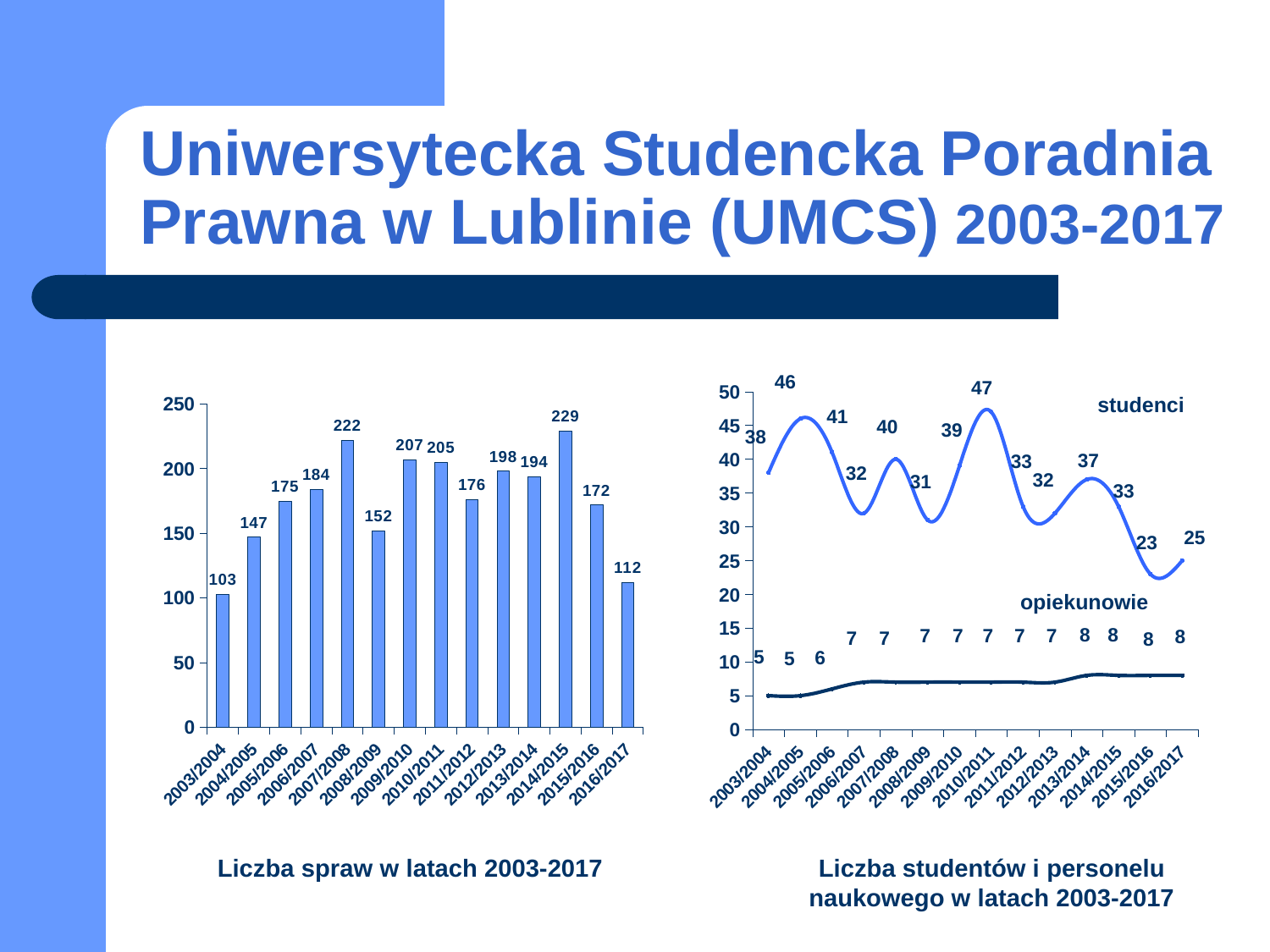
What kind of chart is the left chart (Liczba spraw w latach 2003-2017)? bar chart In the left chart (Liczba spraw w latach 2003-2017), what is the difference between the values for 2014/2015 and 2016/2017? 117 In the right chart (Liczba studentów i personelu naukowego w latach 2003-2017), what is the value for opiekunowie in 2005/2006? 6 In the right chart (Liczba studentów i personelu naukowego w latach 2003-2017), in which year is the studenci value lowest? 2015/2016 In the right chart (Liczba studentów i personelu naukowego w latach 2003-2017), what is the difference between studenci and opiekunowie in 2003/2004? 33 In the left chart (Liczba spraw w latach 2003-2017), which is larger: the value for 2009/2010 or the value for 2010/2011? 2009/2010 In the left chart (Liczba spraw w latach 2003-2017), which year has the highest number of cases? 2014/2015 In the right chart (Liczba studentów i personelu naukowego w latach 2003-2017), what is the value for studenci in 2010/2011? 47 In the left chart (Liczba spraw w latach 2003-2017), what is the value for 2007/2008? 222 In the left chart (Liczba spraw w latach 2003-2017), which year has the lowest number of cases? 2003/2004 In the left chart (Liczba spraw w latach 2003-2017), how many years are shown on the x axis? 14 How many series are plotted in the right chart (Liczba studentów i personelu naukowego w latach 2003-2017)? 2